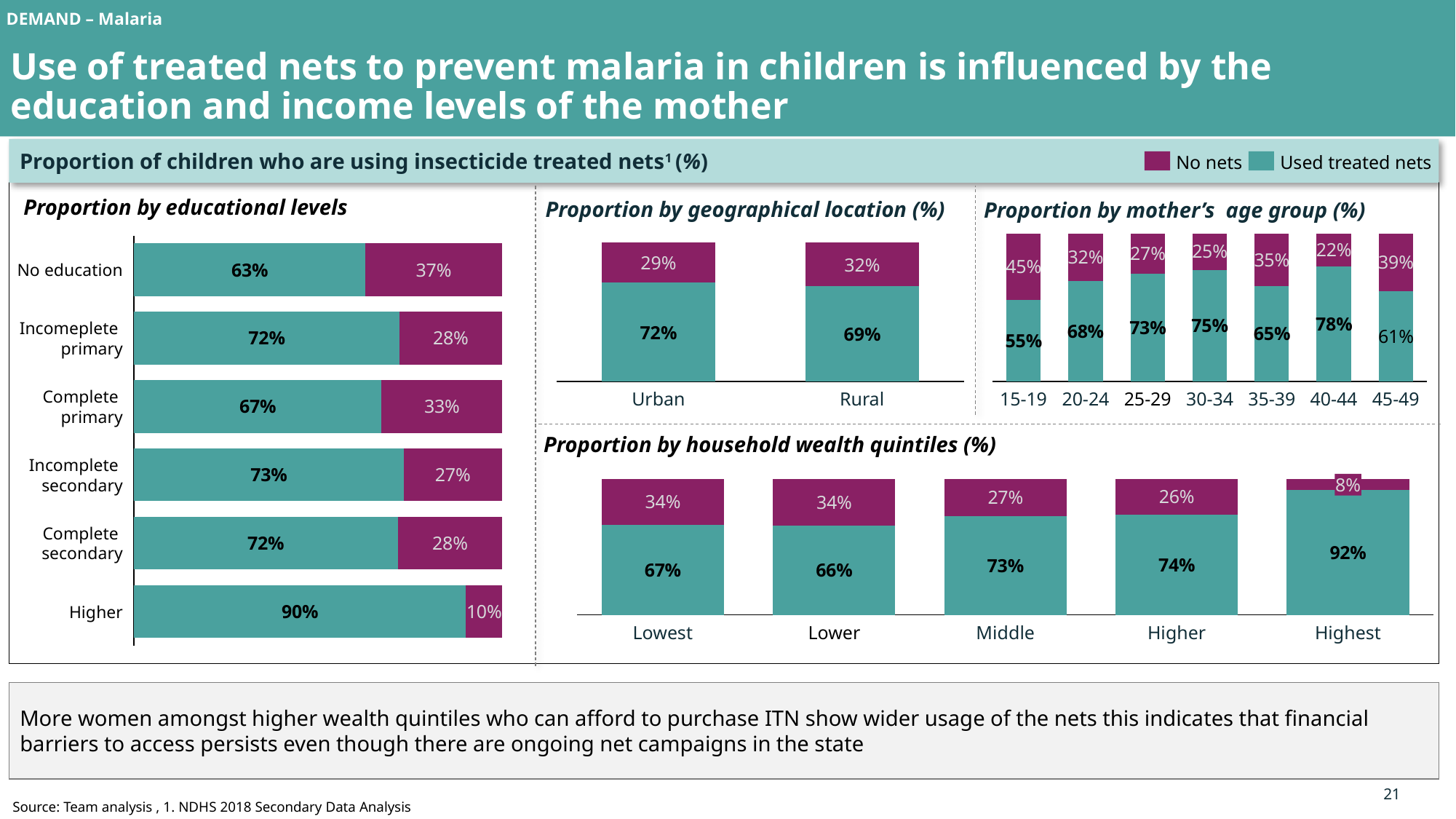
In the 'Proportion by geographical location' chart, what is the 'Used treated nets' value for Rural? 69% In the 'Proportion by household wealth quintiles' chart, which is larger, the 'Used treated nets' value for Middle or for Higher? Higher How many series does the legend list for the charts on this slide? 2 In the 'Proportion by geographical location' chart, what is the difference between the Urban and Rural 'Used treated nets' values? 3% In the 'Proportion by educational levels' chart, what is the 'No nets' value for the Higher education level? 10% In the 'Proportion by educational levels' chart, which educational level has the highest share of children using treated nets? Higher In the 'Proportion by mother's age group' chart, how many age groups are shown? 7 In the 'Proportion by household wealth quintiles' chart, what is the 'No nets' value for the Highest quintile? 8% In the 'Proportion by educational levels' chart, how many educational level categories are shown? 6 In the 'Proportion by mother's age group' chart, which age group has the lowest share of children using treated nets? 15-19 In the 'Proportion by mother's age group' chart, what is the 'Used treated nets' value for the 40-44 age group? 78% In the 'Proportion by educational levels' chart, what percentage of children of mothers with no education used treated nets? 63%